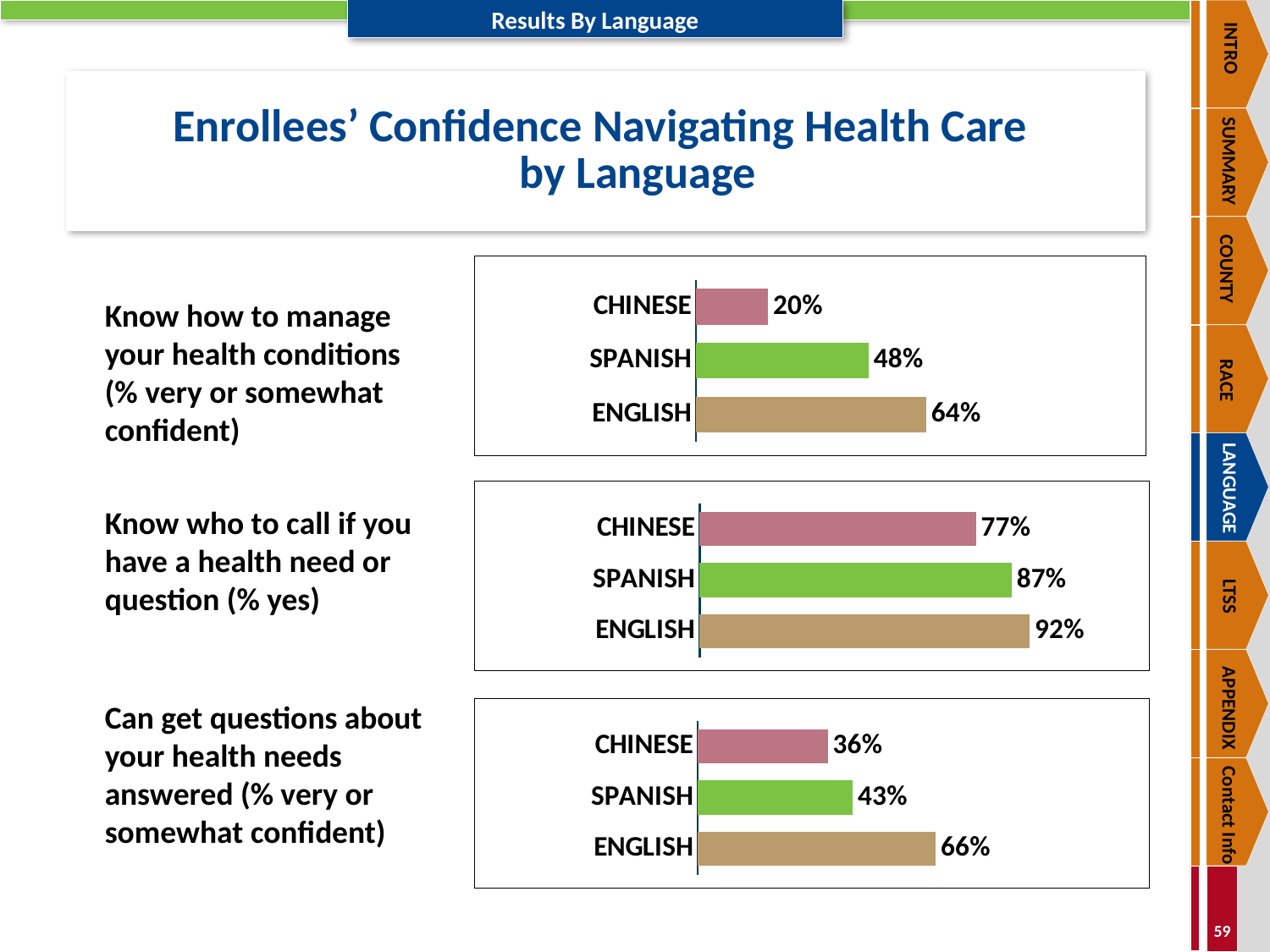
In the bottom chart (Can get questions about your health needs answered), which is larger, the value for Chinese or the value for Spanish? Spanish In the top chart (Know how to manage your health conditions), which language has the highest value? English In the top chart (Know how to manage your health conditions), what is the difference between the English and Spanish values? 16% In the bottom chart (Can get questions about your health needs answered), what is the value for English? 66% What kind of chart is the middle chart (Know who to call if you have a health need or question)? Bar chart In the middle chart (Know who to call if you have a health need or question), what is the difference between the English and Chinese values? 15% How many language categories are shown in the top chart (Know how to manage your health conditions)? 3 In the bottom chart (Can get questions about your health needs answered), what is the difference between the Spanish and Chinese values? 7% In the middle chart (Know who to call if you have a health need or question), what is the value for Spanish? 87% What is the title of the slide containing these charts? Enrollees' Confidence Navigating Health Care by Language In the top chart (Know how to manage your health conditions), what is the value for Chinese? 20% In the middle chart (Know who to call if you have a health need or question), which language has the lowest value? Chinese